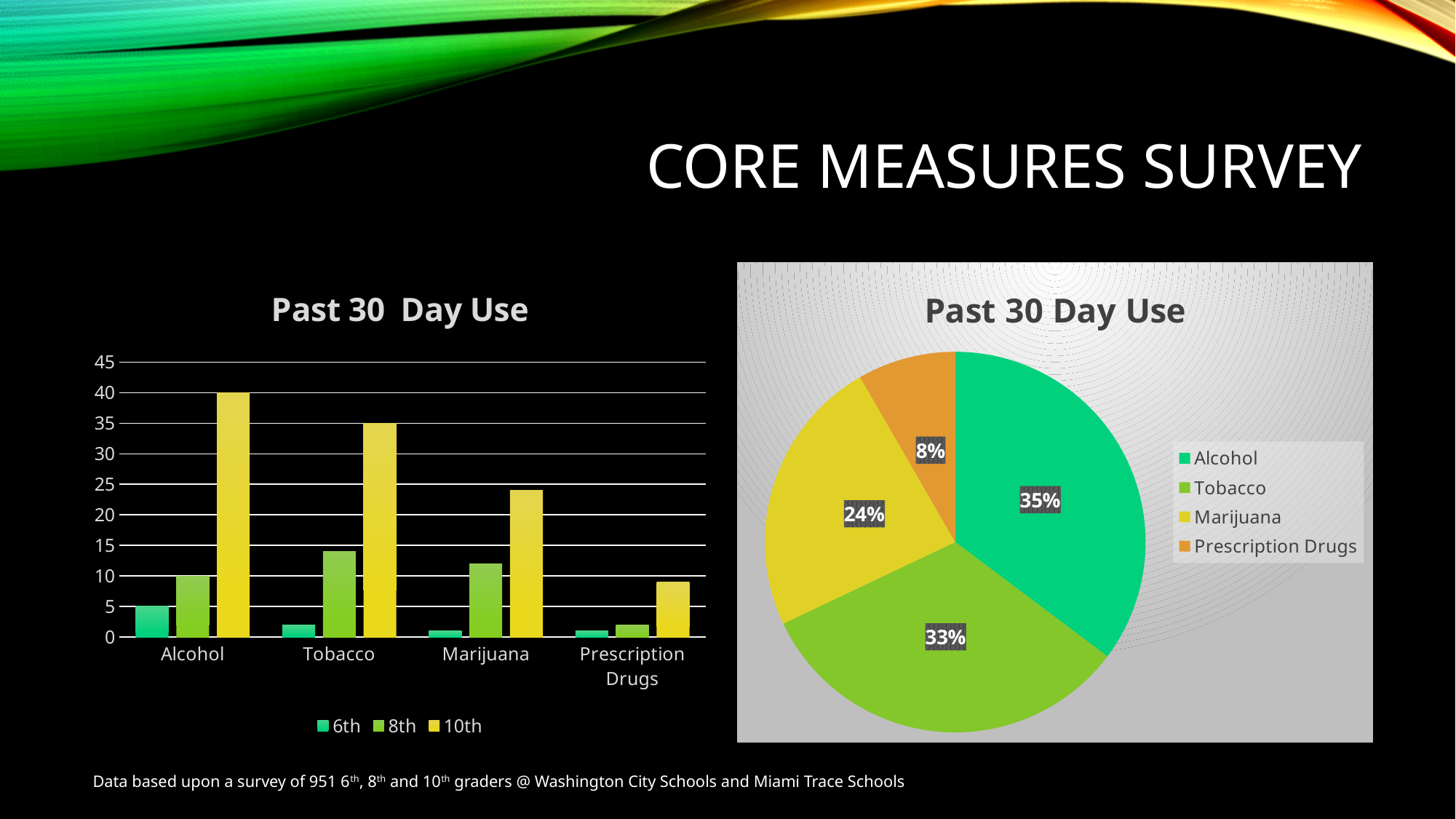
On the bar chart on the left, what is the value for 10th graders for Tobacco? 35 On the bar chart on the left, what is the value for 6th graders for Alcohol? 5 On the bar chart on the left, is the 10th grade value for Marijuana greater or less than 20? greater On the bar chart on the left, what is the value for 10th graders for Alcohol? 40 On the pie chart on the right, which slice is the smallest? Prescription Drugs On the pie chart on the right, what is the difference between the Alcohol and Marijuana shares? 11% On the bar chart on the left, which category has the highest 10th grade bar? Alcohol On the bar chart on the left, is the 8th grade value for Tobacco greater or less than 10? greater On the bar chart on the left, how many series does the legend list? 3 What kind of chart is on the right side of the slide? Pie chart On the bar chart on the left, how many categories are shown on the x axis? 4 On the pie chart on the right, what share does Tobacco have? 33%